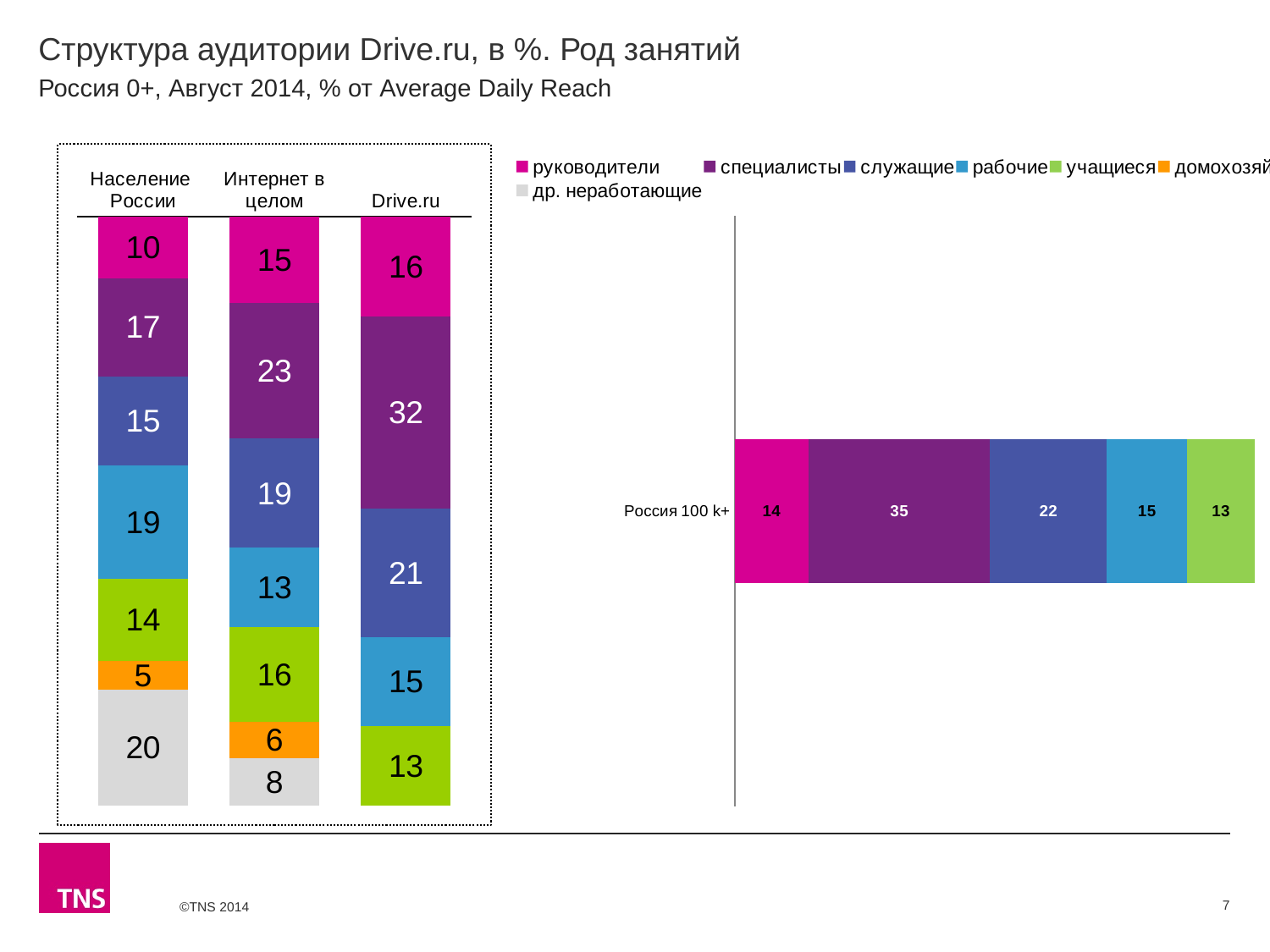
How many bars (categories) does the left stacked bar chart show? 3 What type of chart is shown on the right side of the slide? Stacked bar chart In the left stacked bar chart, which segment is the smallest in the Население России bar? домохозяйки In the left stacked bar chart, what is the difference between the специалисты values for Drive.ru and Население России? 22 In the left stacked bar chart, what is the value of the рабочие (light blue) segment for Интернет в целом? 13 How many series does the legend list? 7 In the left stacked bar chart, which is larger: the руководители value for Drive.ru or for Население России? Drive.ru In the left stacked bar chart, which segment is the largest in the Drive.ru bar? специалисты In the right chart, what is the value of the специалисты (purple) segment for Россия 100 k+? 35 In the left stacked bar chart, what is the value of the др. неработающие (grey) segment for Население России? 20 In the right chart, what is the total of the Россия 100 k+ bar? 99 In the left stacked bar chart, what is the value of the специалисты (purple) segment for Drive.ru? 32